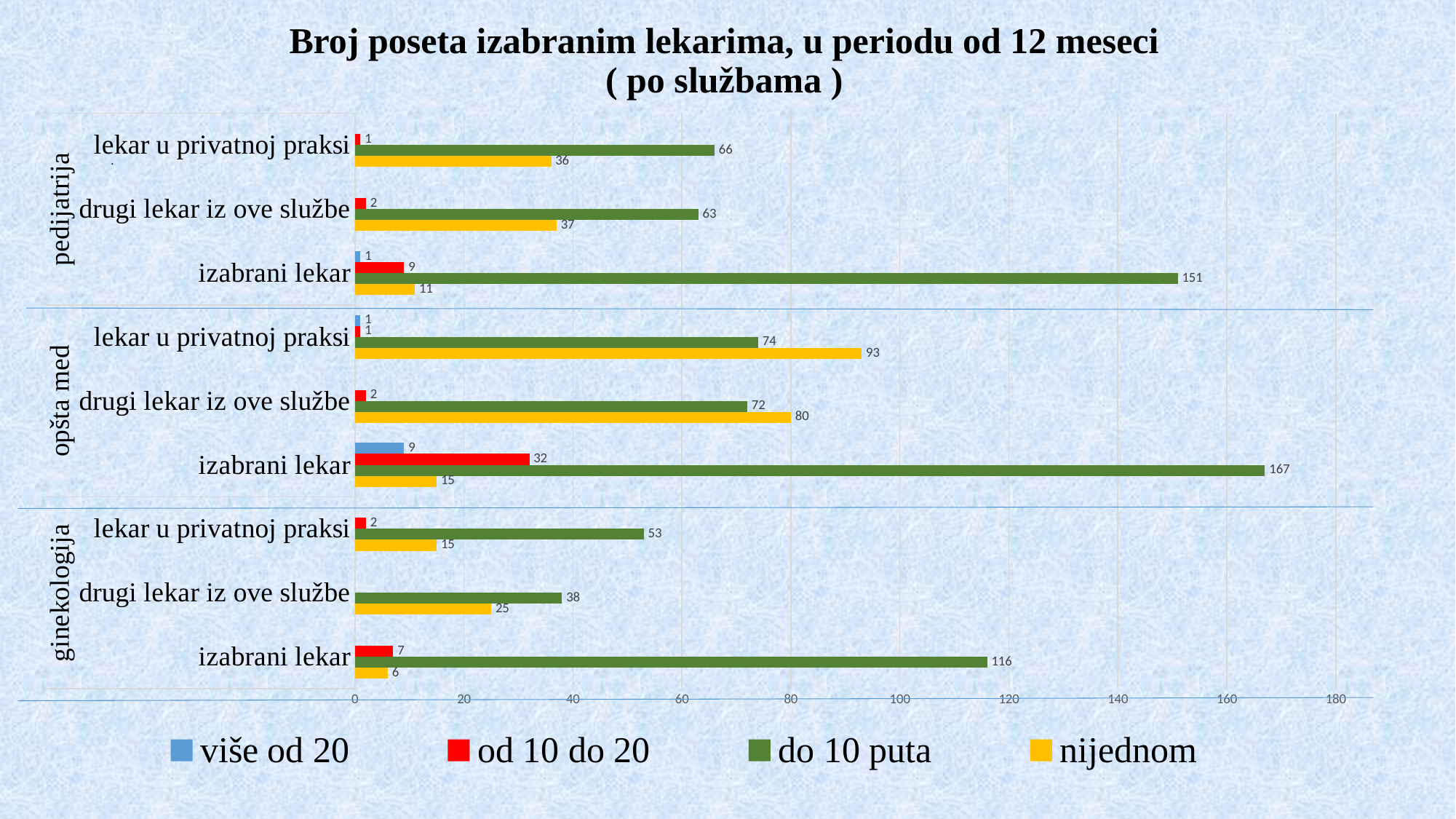
In the opšta med group, which is larger for 'drugi lekar iz ove službe': 'do 10 puta' or 'nijednom'? nijednom What is the value of 'od 10 do 20' for 'izabrani lekar' in the ginekologija group? 7 What is the value of 'više od 20' for 'izabrani lekar' in the opšta med group? 9 What is the value of 'nijednom' for 'lekar u privatnoj praksi' in the opšta med group? 93 What kind of chart is shown on the slide? bar chart What is the difference between the 'do 10 puta' values for 'izabrani lekar' in opšta med and pedijatrija? 16 What is the value of 'do 10 puta' for 'drugi lekar iz ove službe' in the pedijatrija group? 63 How many series does the legend list? 4 Which group's 'izabrani lekar' has the highest 'do 10 puta' value? opšta med What is the value of 'do 10 puta' for 'izabrani lekar' in the opšta med group? 167 Which legend entry is shown in green? do 10 puta Which group's 'izabrani lekar' has the lowest 'do 10 puta' value? ginekologija